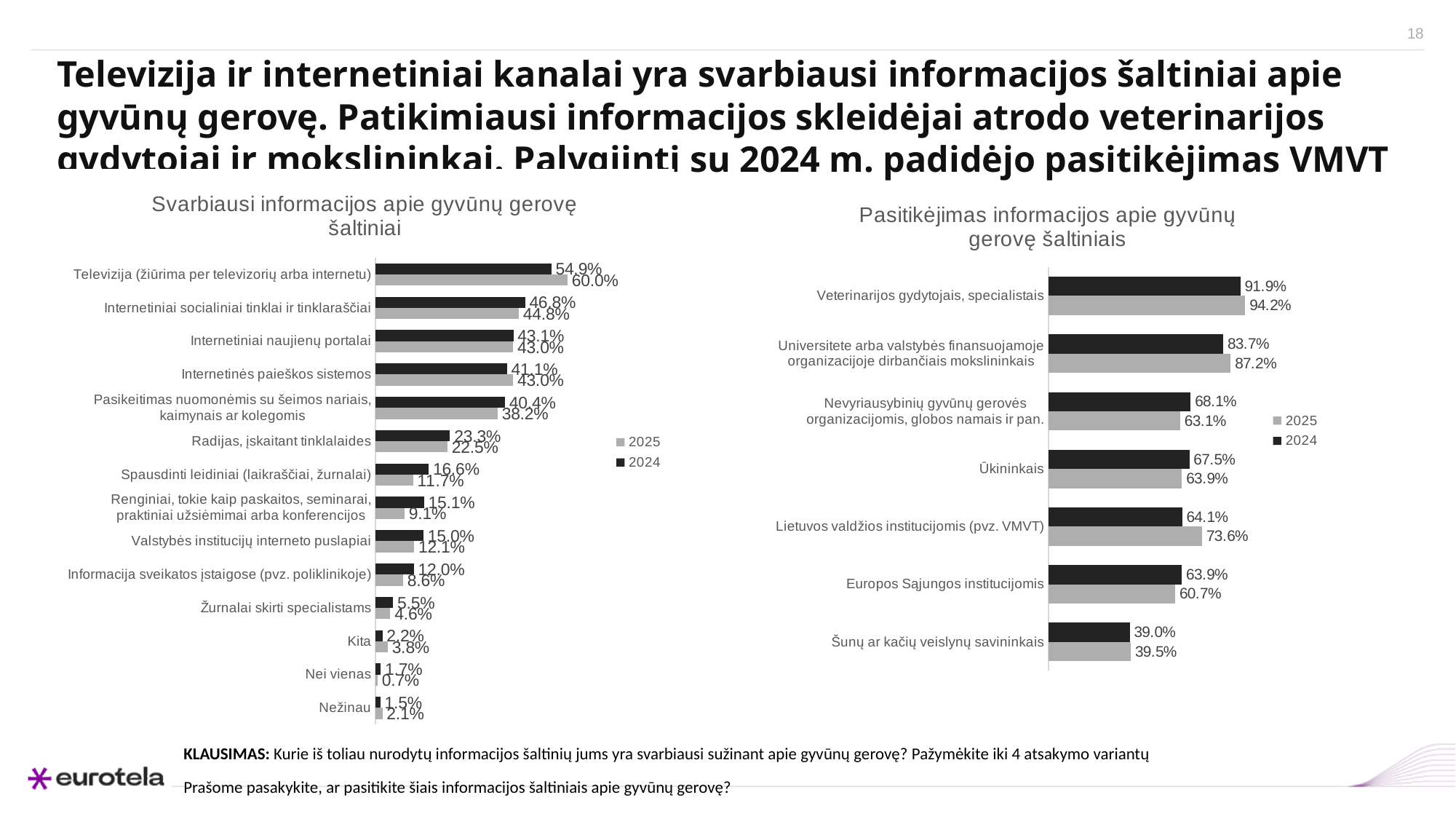
How many series does the legend of the chart titled "Pasitikėjimas informacijos apie gyvūnų gerovę šaltiniais" list? 2 What type of chart is the chart titled "Pasitikėjimas informacijos apie gyvūnų gerovę šaltiniais"? Bar chart In the chart titled "Svarbiausi informacijos apie gyvūnų gerovę šaltiniai", which category has the highest 2025 value? Televizija (žiūrima per televizorių arba internetu) In the chart titled "Svarbiausi informacijos apie gyvūnų gerovę šaltiniai", what is the 2025 value for "Televizija (žiūrima per televizorių arba internetu)"? 60.0% In the chart titled "Svarbiausi informacijos apie gyvūnų gerovę šaltiniai", which category has the lowest 2025 value? Nei vienas In the chart titled "Svarbiausi informacijos apie gyvūnų gerovę šaltiniai", what is the 2024 value for "Radijas, įskaitant tinklalaides"? 23.3% In the chart titled "Pasitikėjimas informacijos apie gyvūnų gerovę šaltiniais", what is the difference between the 2025 and 2024 values for "Veterinarijos gydytojais, specialistais"? 2.3% In the chart titled "Pasitikėjimas informacijos apie gyvūnų gerovę šaltiniais", is the 2025 value for "Ūkininkais" larger or smaller than the 2024 value? smaller In the chart titled "Svarbiausi informacijos apie gyvūnų gerovę šaltiniai", what is the difference between the 2024 and 2025 values for "Spausdinti leidiniai (laikraščiai, žurnalai)"? 4.9% In the chart titled "Pasitikėjimas informacijos apie gyvūnų gerovę šaltiniais", which category has the lowest 2024 value? Šunų ar kačių veislynų savininkais In the chart titled "Svarbiausi informacijos apie gyvūnų gerovę šaltiniai", how many categories are shown? 14 In the chart titled "Pasitikėjimas informacijos apie gyvūnų gerovę šaltiniais", what is the 2025 value for "Lietuvos valdžios institucijomis (pvz. VMVT)"? 73.6%